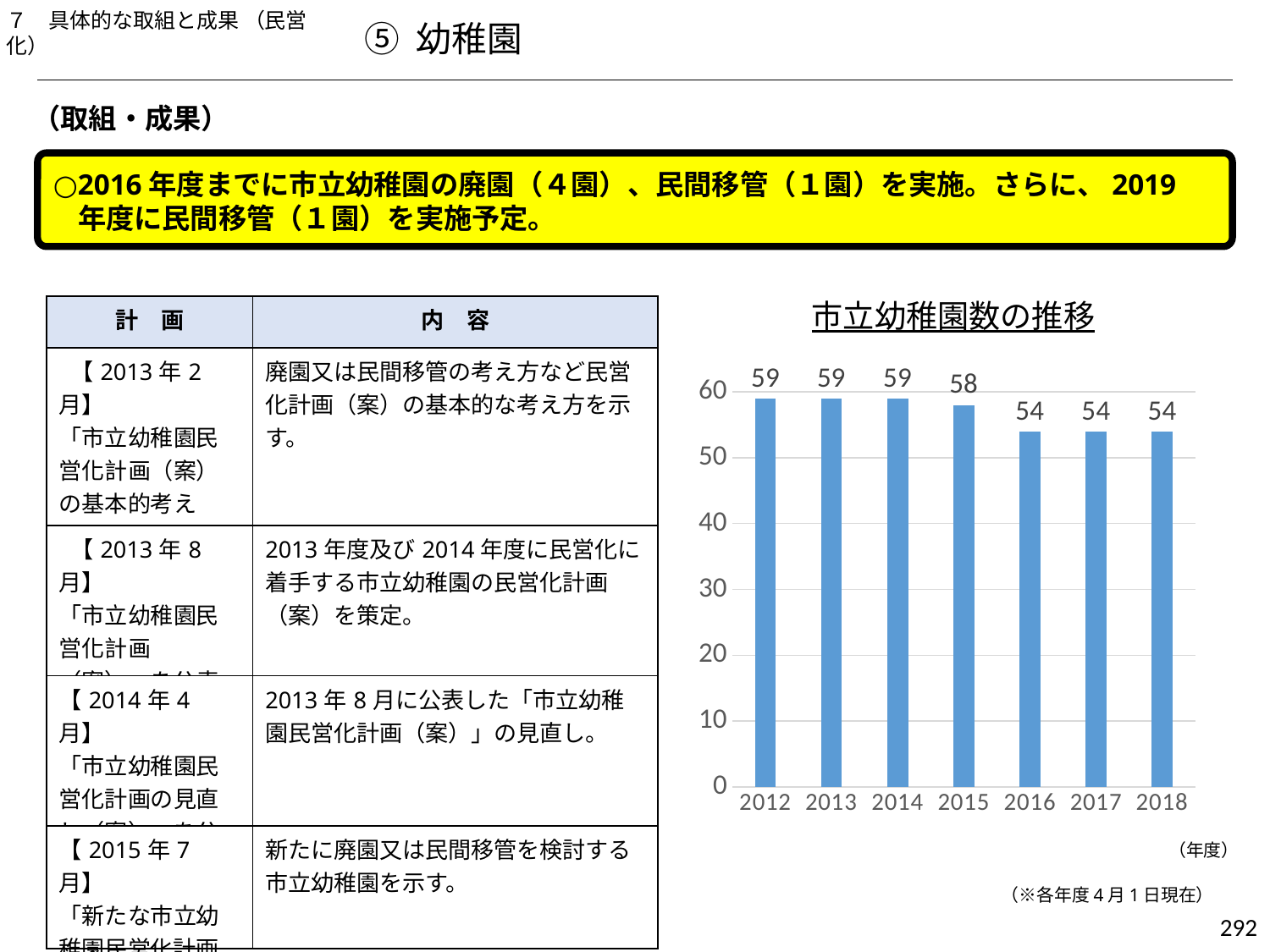
What is the difference between the values for 2015 and 2016? 4 What is the value for 2018 in the 市立幼稚園数の推移 chart? 54 What is the title of the chart? 市立幼稚園数の推移 Is the value for 2016 greater or less than 50? greater How many years are shown on the x axis of the chart? 7 What is the value for 2012 in the 市立幼稚園数の推移 chart? 59 Which is larger, the value for 2014 or the value for 2017? 2014 Do the values rise or fall from 2012 to 2018? fall What is the value for 2015 in the 市立幼稚園数の推移 chart? 58 What is the difference between the values for 2012 and 2018? 5 Which year has the lowest value in the chart? If several tie, name the earliest. 2016 What kind of chart is shown on the slide? bar chart